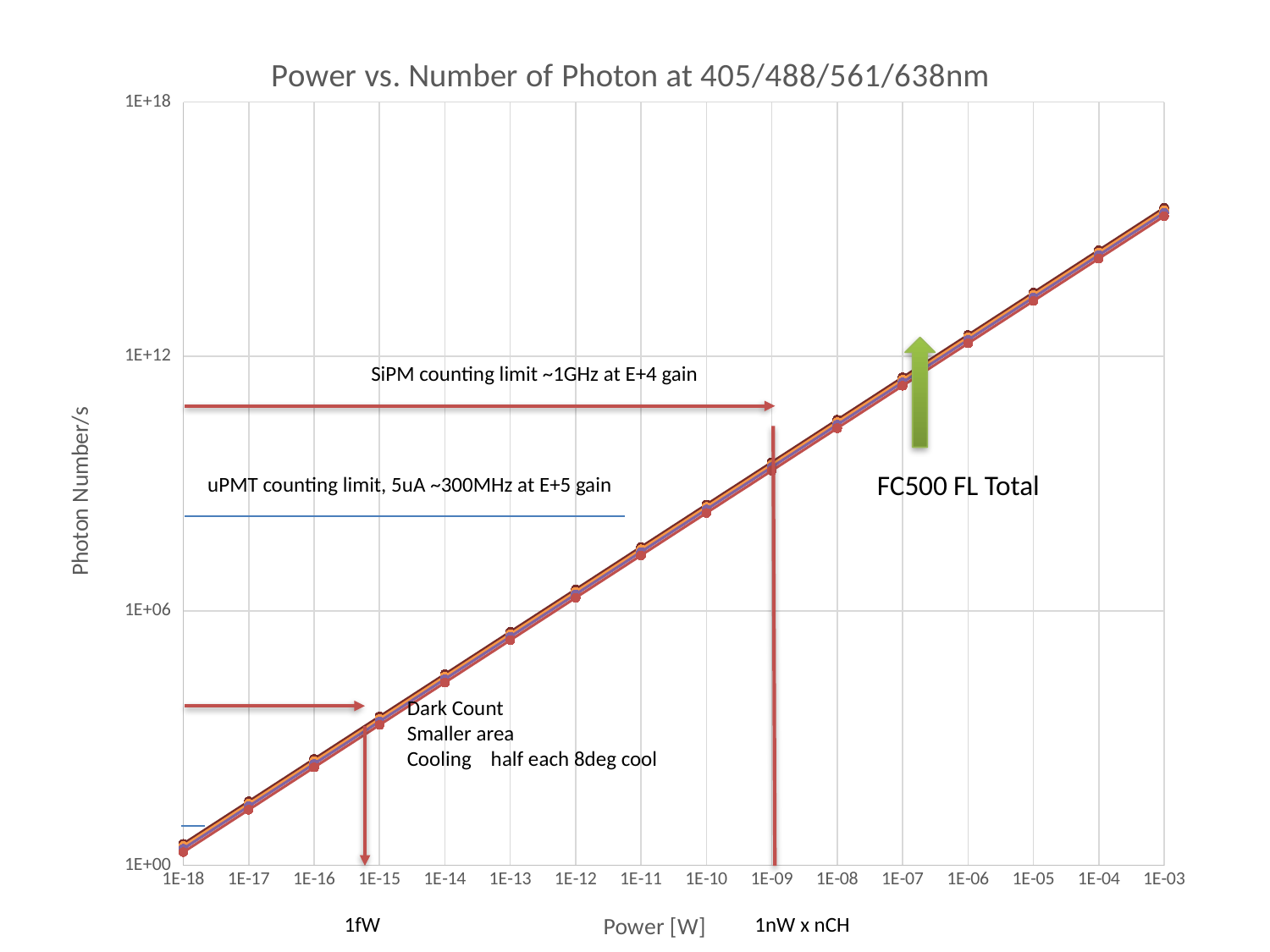
Is the photon number per second at a power of 1E-03 W greater or less than 1E+12? greater How many power values (x-axis ticks) are shown from 1E-18 to 1E-03? 16 What kind of chart is shown on the slide? line chart Is the photon number per second at a power of 1E-15 W greater or less than 1E+06? less Do the plotted values rise or fall as power increases along the x axis? rise Is the photon number per second at a power of 1E-09 W greater or less than 1E+12? less At which power value is the photon number per second lowest? 1E-18 What is the label of the y axis? Photon Number/s Which has the larger photon number per second: a power of 1E-09 W or 1E-15 W? 1E-09 What is the title of the chart? Power vs. Number of Photon at 405/488/561/638nm At which power value is the photon number per second highest? 1E-03